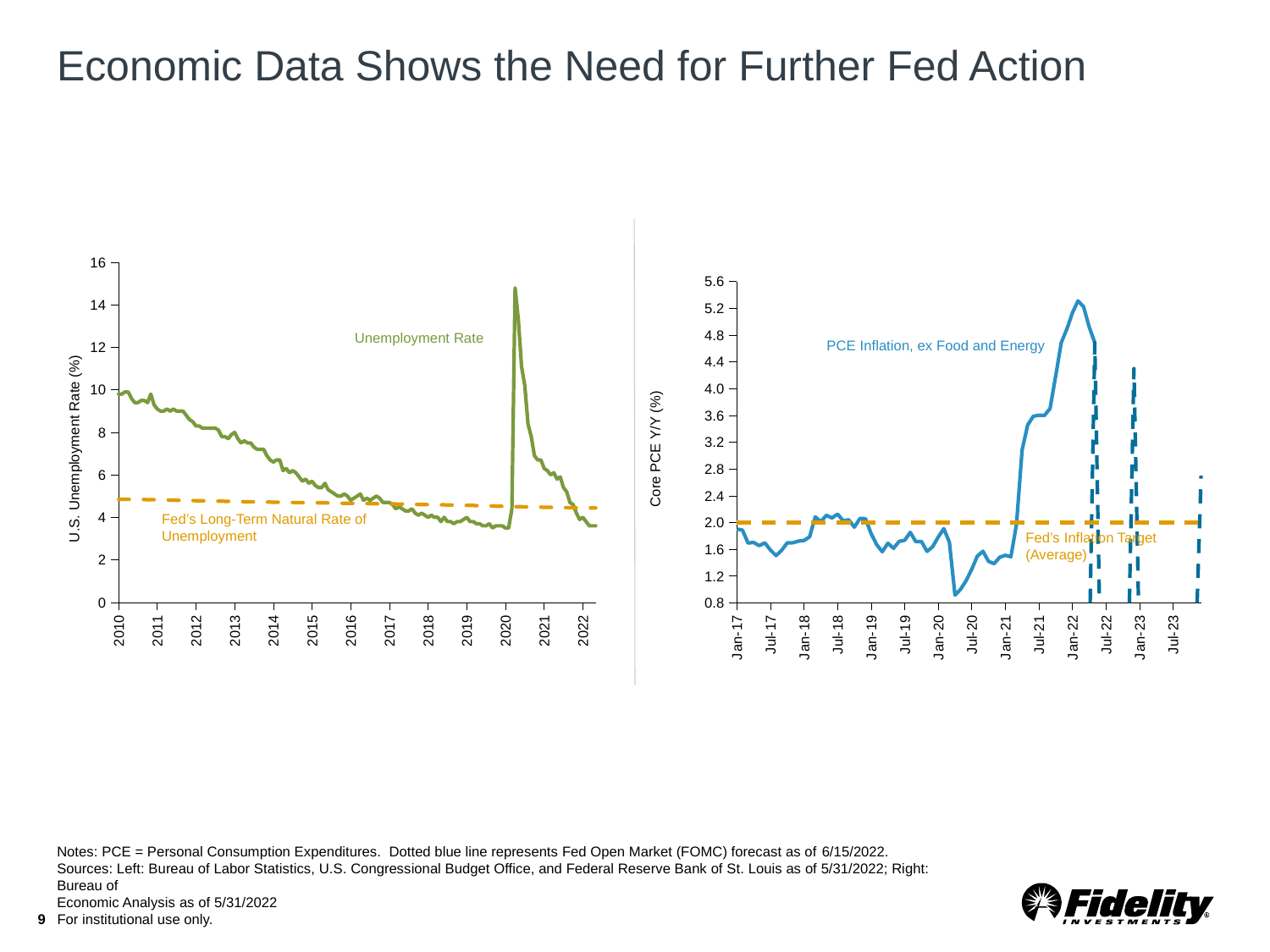
What kind of chart is the left chart showing the U.S. Unemployment Rate? line chart On the left chart, in which year does the Unemployment Rate reach its highest point? 2020 On the left chart, is the Fed's Long-Term Natural Rate of Unemployment greater or less than 6? less On the left chart, is the Unemployment Rate at the start of 2010 greater or less than 8? greater On the right chart, what value does the dashed line labelled Fed's Inflation Target (Average) sit at? 2.0 On the right chart, is the lowest point of PCE Inflation, ex Food and Energy in 2020 greater or less than 1.2? less On the left chart, does the Unemployment Rate rise or fall between 2010 and 2019? fall On the left chart, which is larger: the Unemployment Rate in 2010 or in 2019? 2010 On the right chart, does PCE Inflation, ex Food and Energy rise or fall between Jan-21 and Jan-22? rise What is the y-axis label of the right chart? Core PCE Y/Y (%)